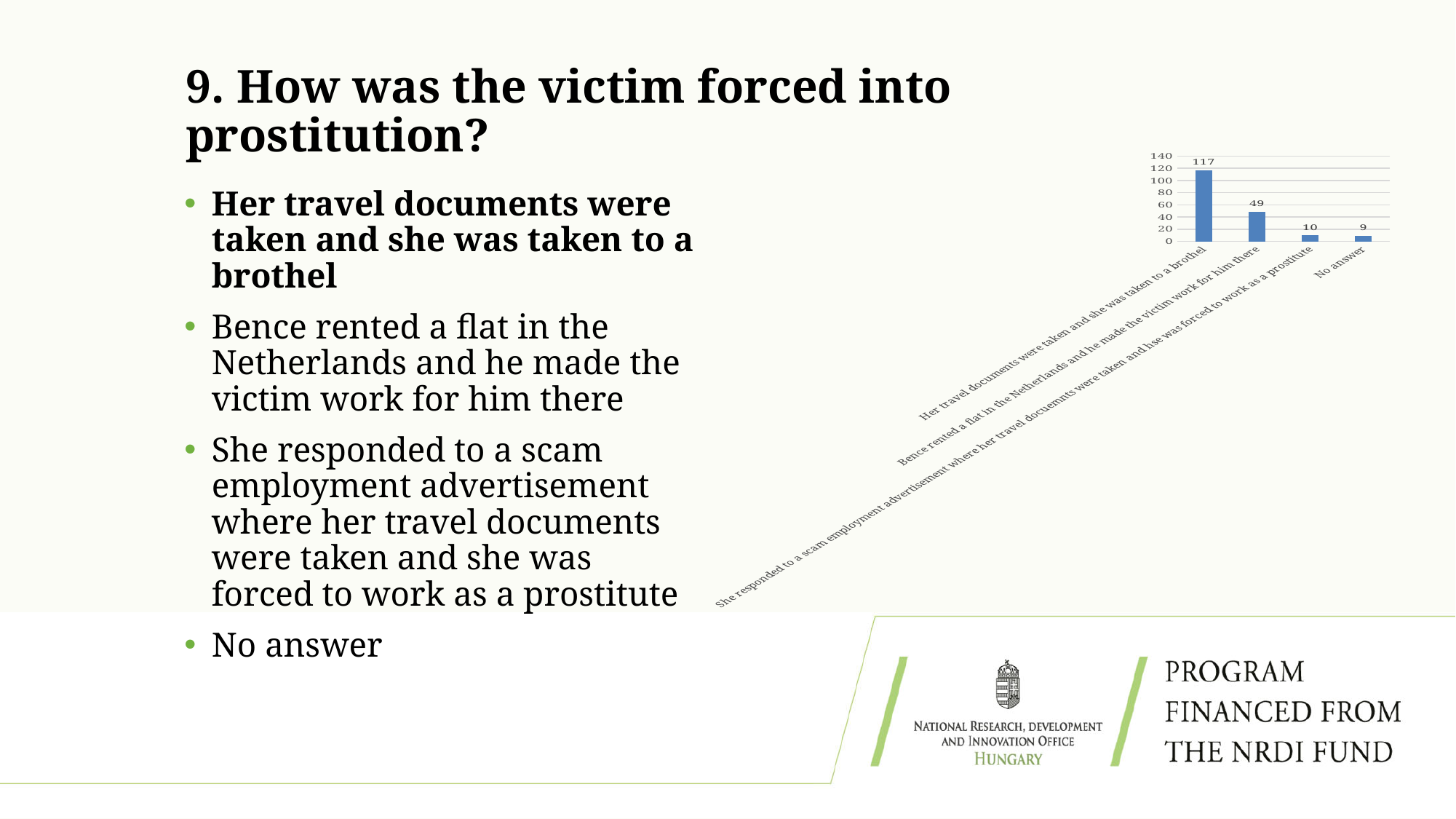
Which category has the lowest value? No answer What is the difference between the value for the scam employment advertisement category and 'No answer'? 1 What is the value for 'No answer'? 9 What is the value for 'Her travel documents were taken and she was taken to a brothel'? 117 Which category has the highest value? Her travel documents were taken and she was taken to a brothel What is the difference between the value for 'Her travel documents were taken and she was taken to a brothel' and the value for 'Bence rented a flat in the Netherlands and he made the victim work for him there'? 68 Which is larger: the value for 'Bence rented a flat in the Netherlands and he made the victim work for him there' or the value for 'No answer'? Bence rented a flat in the Netherlands and he made the victim work for him there Is the value for 'Her travel documents were taken and she was taken to a brothel' greater or less than 100? greater How many categories are shown in the chart? 4 What kind of chart is shown on the slide? bar chart What is the value for the category about responding to a scam employment advertisement? 10 What is the value for 'Bence rented a flat in the Netherlands and he made the victim work for him there'? 49